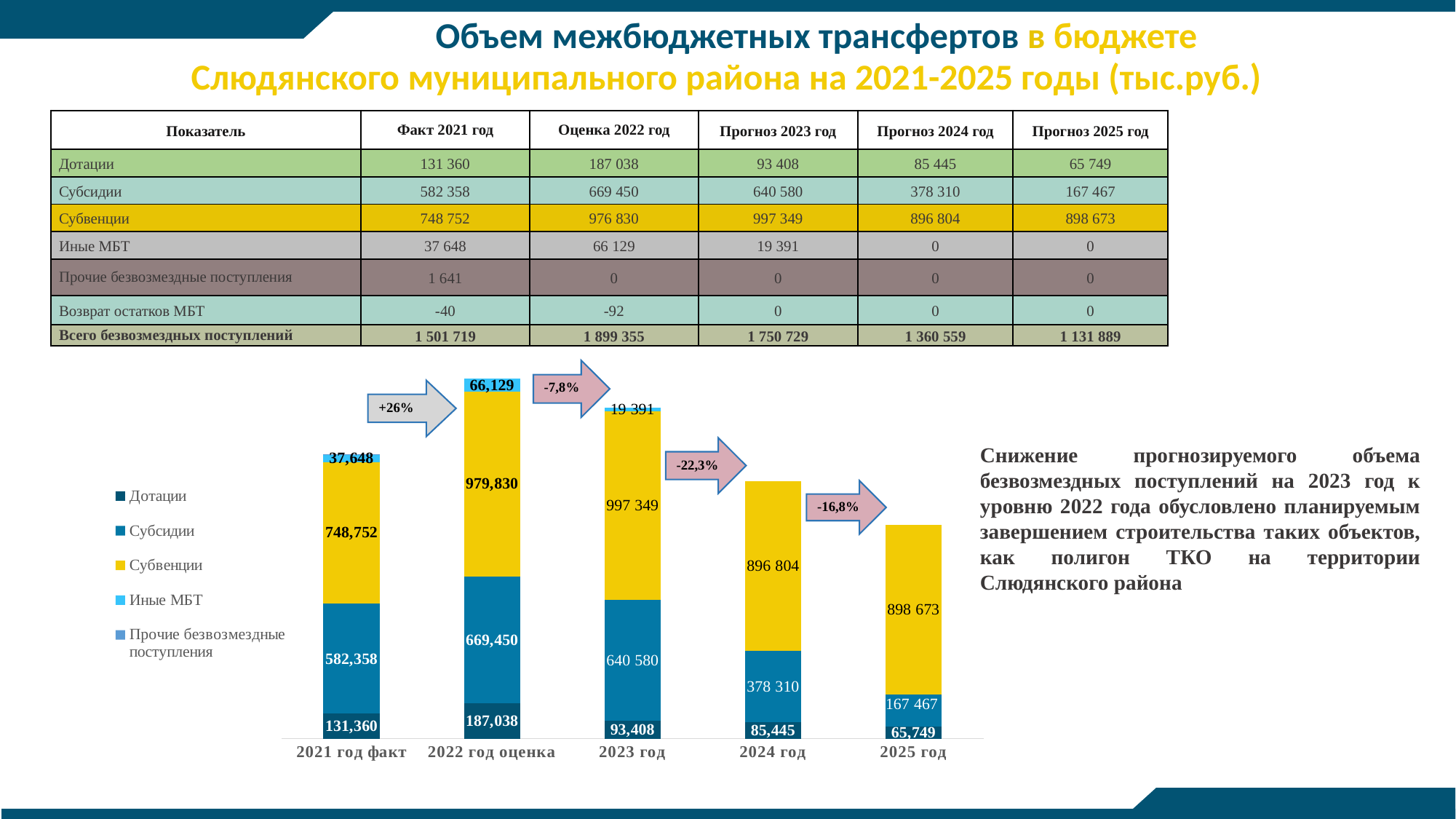
How many series does the chart legend list? 5 What is the difference between Субсидии in 2023 год (640 580) and 2024 год (378 310)? 262 270 Which is larger: Дотации in 2021 год факт or Дотации in 2022 год оценка? 2022 год оценка Do the Субсидии values rise or fall from 2022 год оценка to 2025 год? Fall What is the value of Субвенции for 2023 год in the chart? 997 349 How many year categories are plotted along the x axis of the chart? 5 In which year is the Субсидии segment the largest? 2022 год оценка What kind of chart is shown on the slide? Stacked bar chart What is the value of Субсидии for 2022 год оценка in the chart? 669,450 What is the value of Иные МБТ for 2021 год факт in the chart? 37,648 In which year is the Дотации segment the smallest? 2025 год What is the total of the stacked bar for 2025 год? 1 131 889